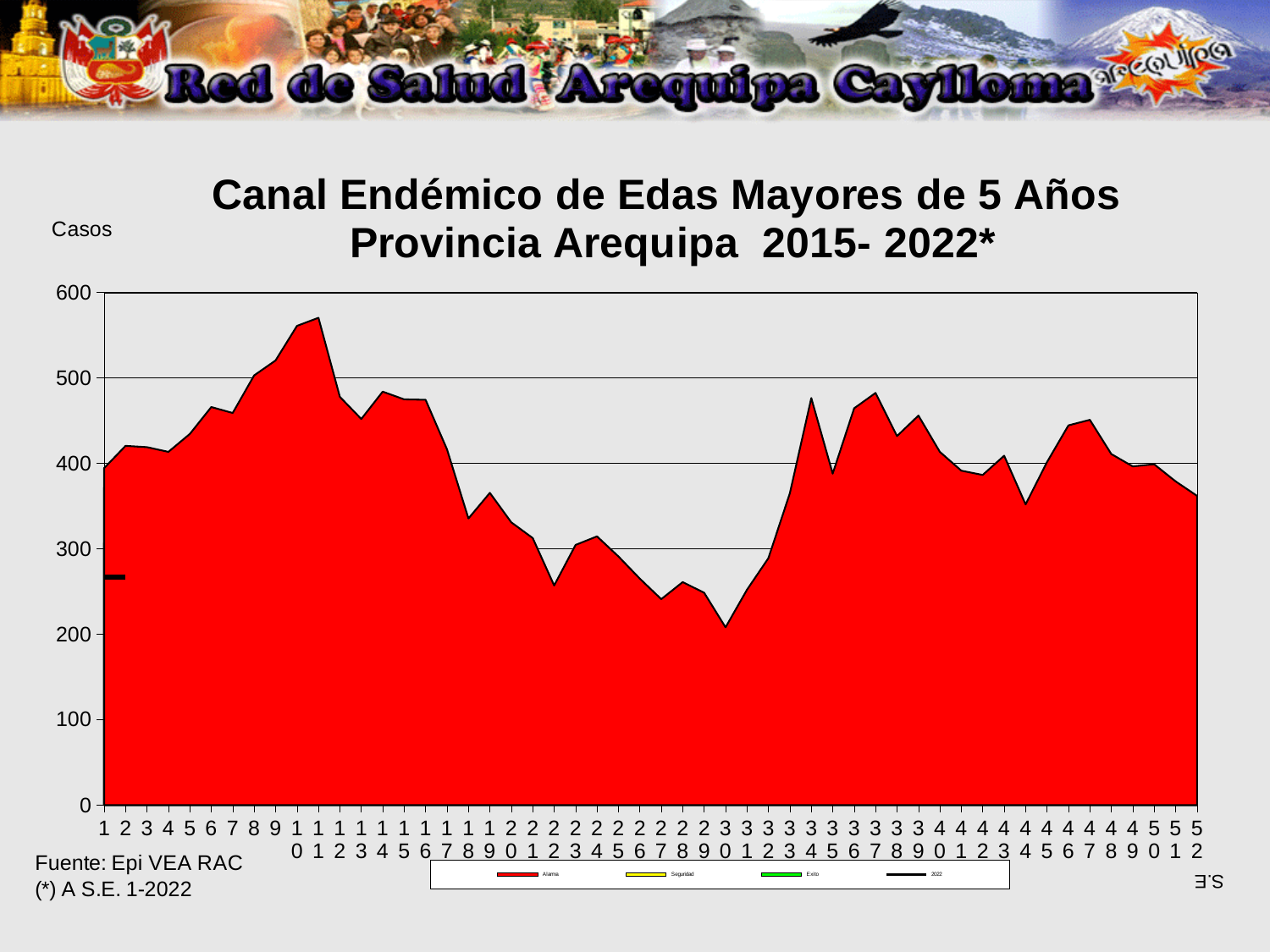
Which week has a higher value, week 11 or week 30? week 11 How many epidemiological weeks (S.E.) are plotted along the x axis? 52 What is the title of the chart? Canal Endémico de Edas Mayores de 5 Años Provincia Arequipa 2015- 2022* How many series does the chart legend list? 4 What is the label of the y axis? Casos At which week does the red Alarma area reach its lowest value? 30 At which week does the red Alarma area reach its highest value? 11 Is the value for week 11 greater or less than 500? greater Is the value for week 30 greater or less than 300? less What kind of chart is shown on the slide? area chart Is the value for week 34 greater or less than 400? greater Between week 11 and week 30, do the values generally rise or fall? fall